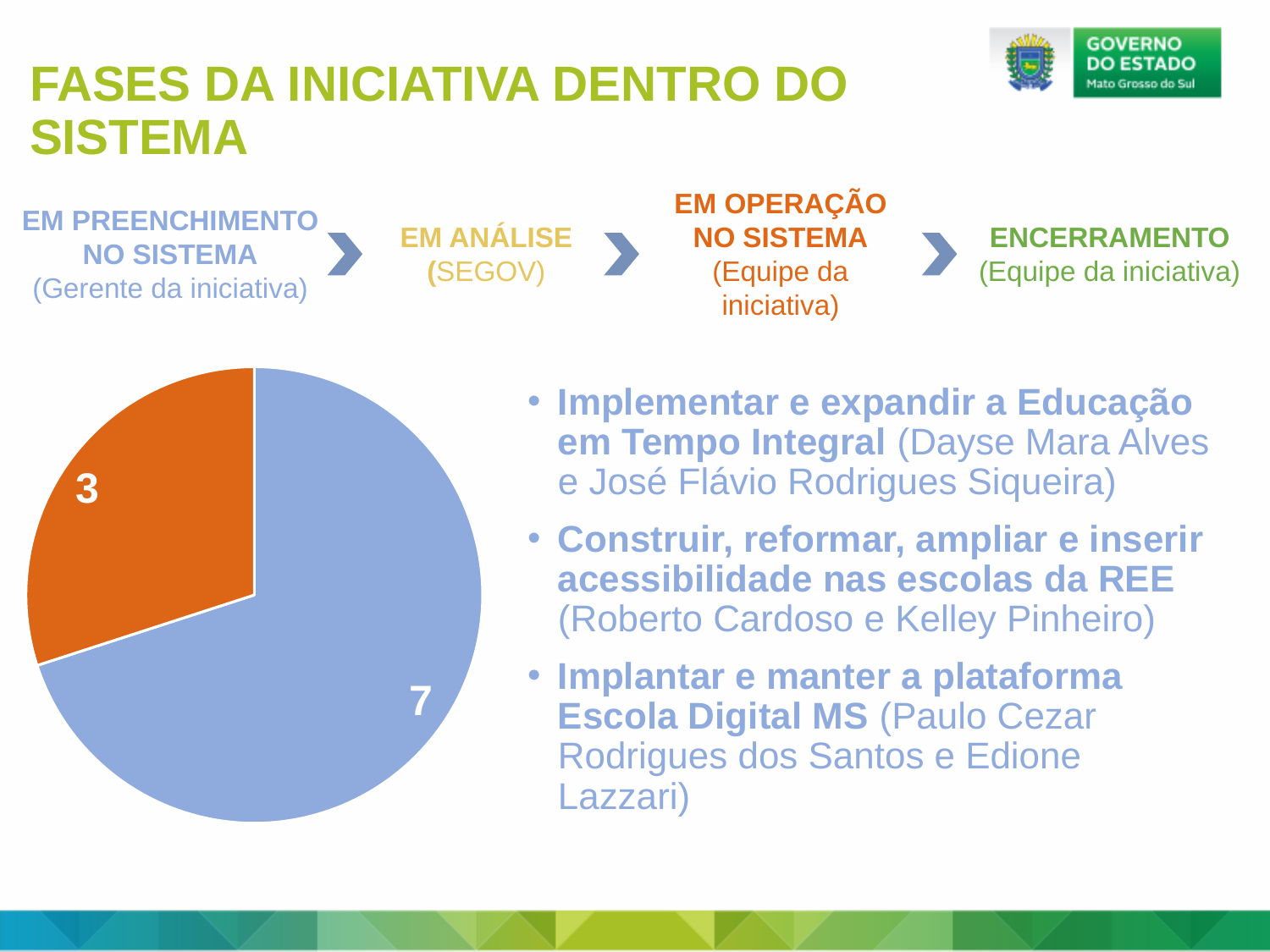
Is the blue slice or the orange slice larger in the pie chart? The blue slice How many slices does the pie chart have? 2 What share of the pie does the orange slice (3) represent? 30% What is the total of the values shown in the pie chart? 10 What value is printed on the orange slice of the pie chart? 3 What is the difference between the blue slice and the orange slice in the pie chart? 4 What share of the pie does the blue slice (7) represent? 70% What kind of chart is shown on the slide? Pie chart What value is printed on the blue slice of the pie chart? 7 Which slice of the pie chart is the largest? The blue slice (7) What two colours are used for the slices of the pie chart? Blue and orange Which slice of the pie chart is the smallest? The orange slice (3)